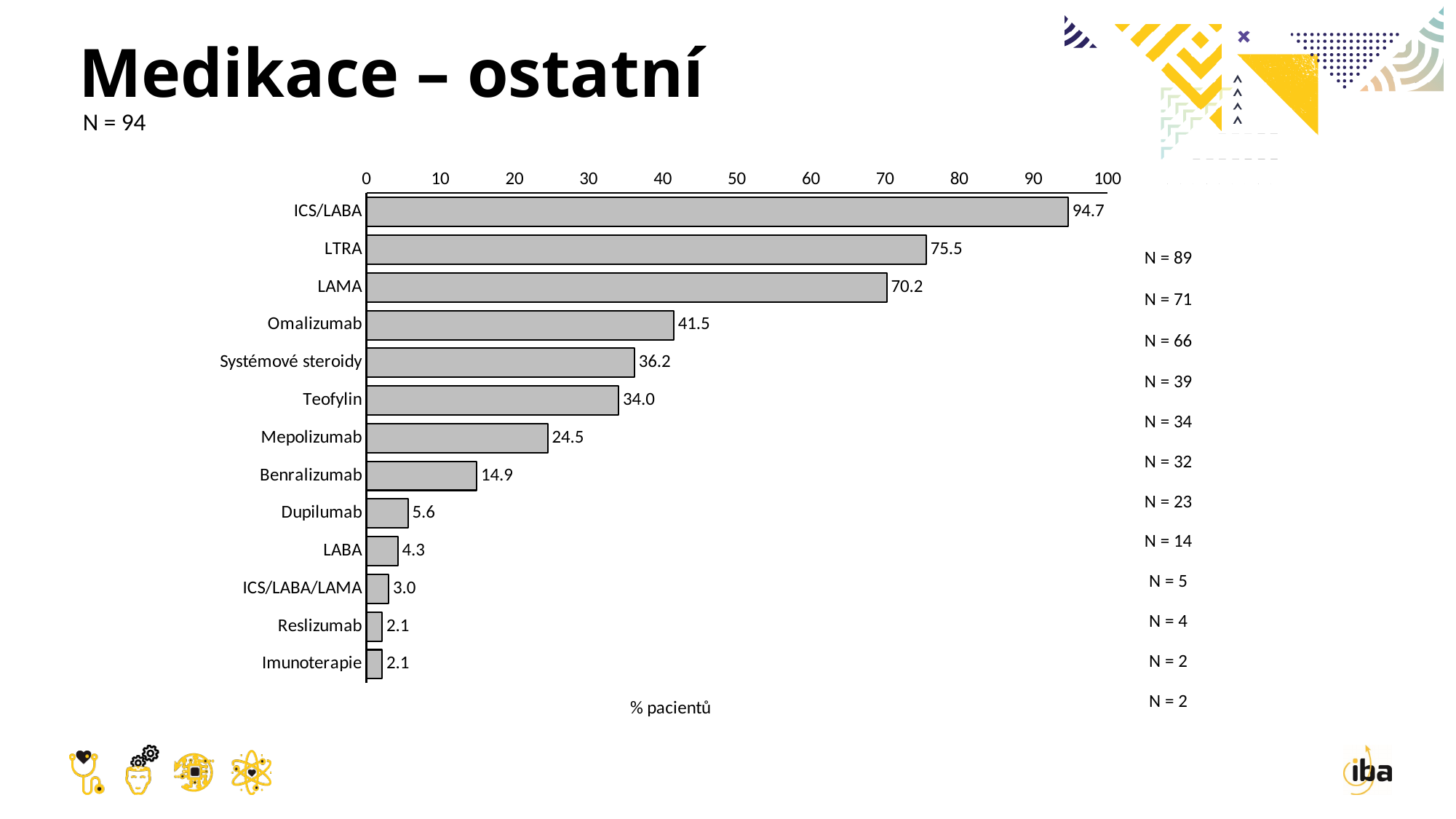
What is the difference between the values for Systémové steroidy and Teofylin? 2.2 What is the value for Benralizumab? 14.9 What is the label of the x axis? % pacientů What is the value for LTRA? 75.5 What is the difference between the values for ICS/LABA and LTRA? 19.2 What kind of chart is shown on the slide? bar chart Which is larger, the value for LAMA or the value for Omalizumab? LAMA What is the value for Omalizumab? 41.5 Is the value for Mepolizumab greater or less than 30? less Which category has the lowest value among those above 3? LABA How many categories are shown in the chart? 13 Which category has the highest value? ICS/LABA